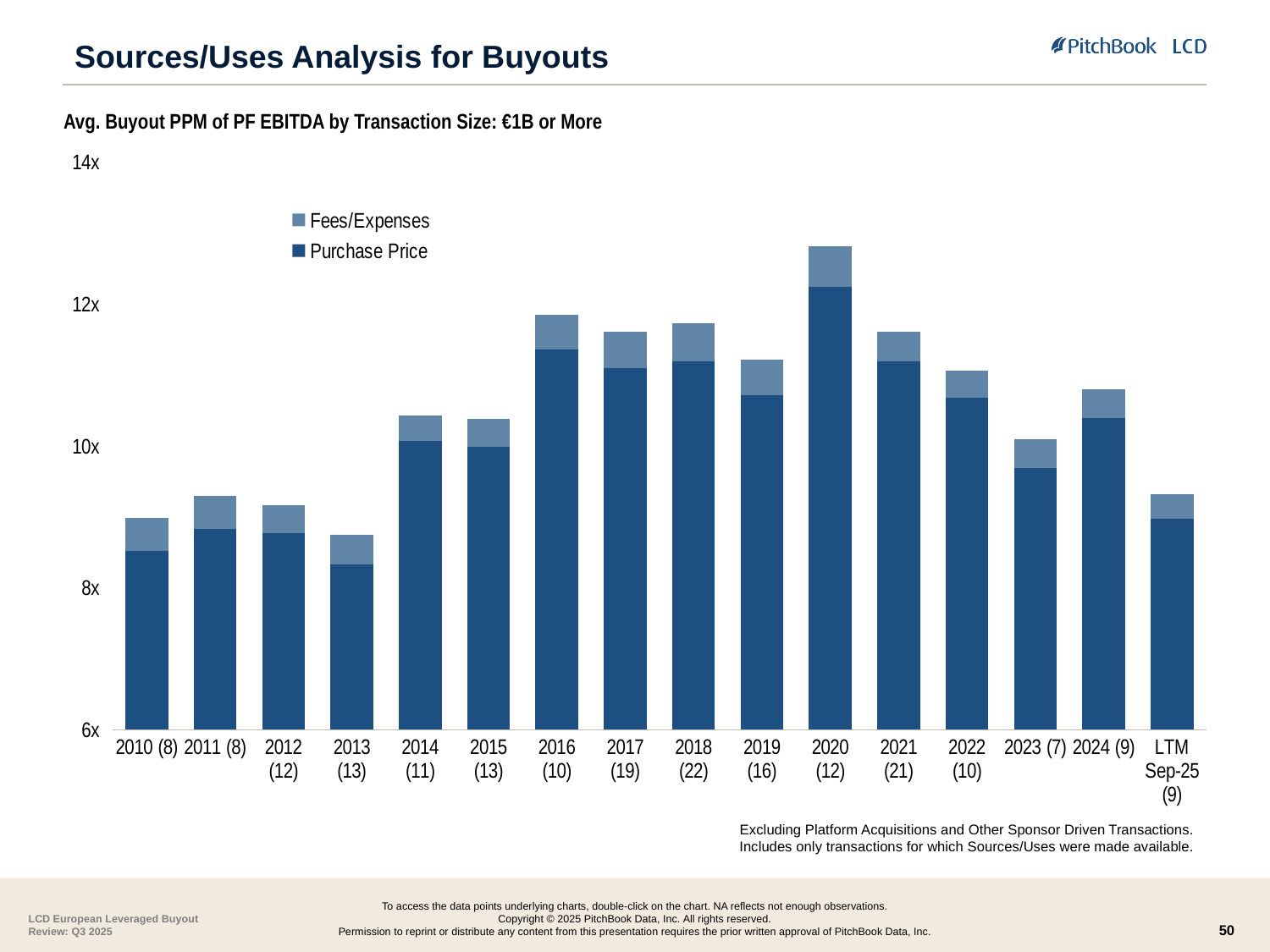
How many bars (periods) are plotted on the chart? 16 Which period has the lowest total bar? 2013 (13) Is the Purchase Price value for 2023 greater or less than 10x? less Which series are listed in the legend? Fees/Expenses and Purchase Price Do the total bars rise or fall from 2020 to 2023? fall Is the total bar for 2013 greater or less than 9x? less Which period has the highest total bar? 2020 (12) Is the total bar for 2020 greater or less than 12x? greater Which has the larger total bar, 2018 or 2019? 2018 What kind of chart is shown on the slide? Stacked bar chart How many series does the legend list? 2